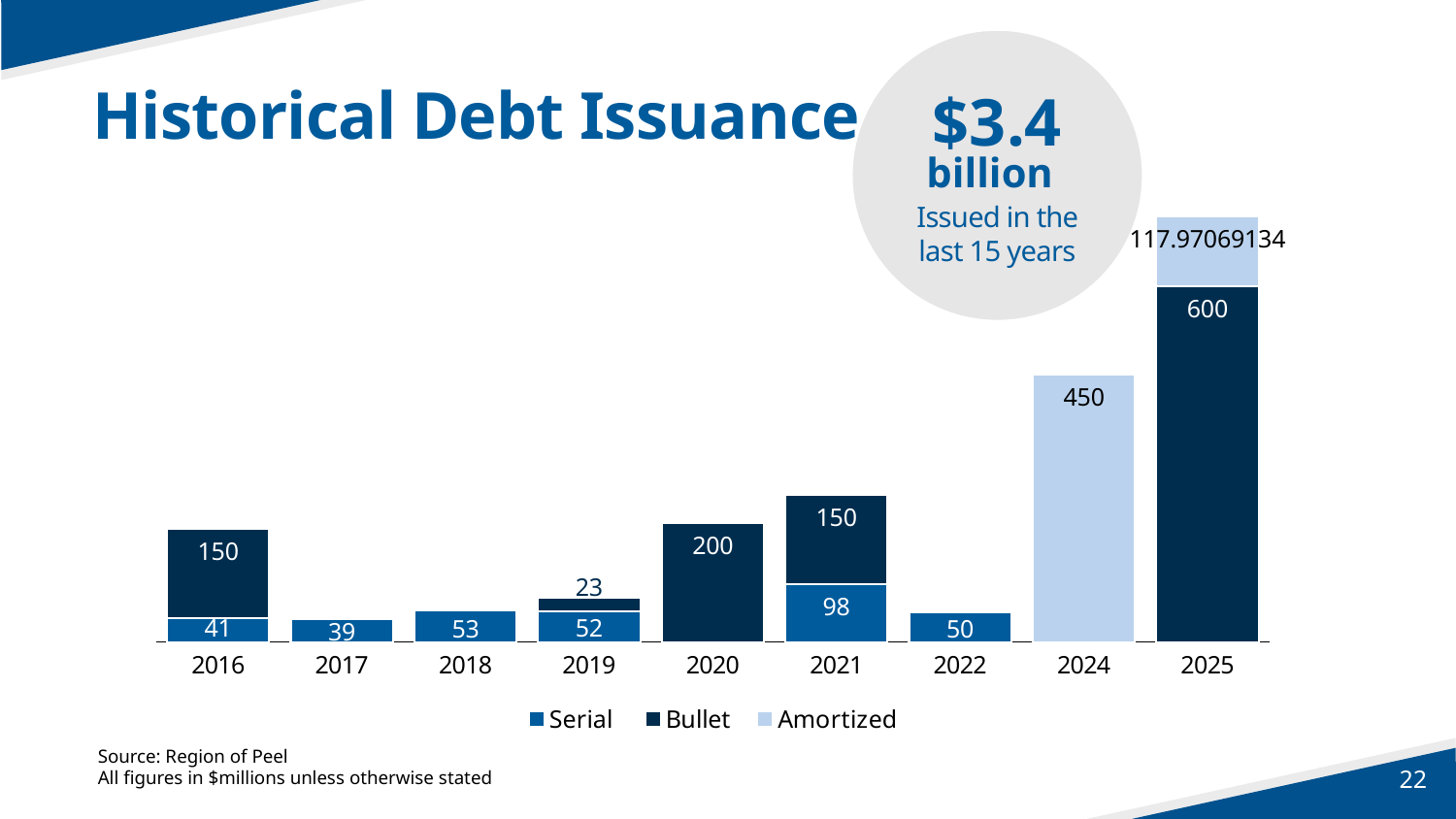
Which year has the highest Bullet value? 2025 Which is larger, the Bullet value for 2016 or the Bullet value for 2019? 2016 What is the Bullet value for 2020? 200 What is the Bullet value for 2025? 600 What is the Amortized value for 2024? 450 What is the total of the stacked bar for 2016? 191 What is the total of the stacked bar for 2021? 248 How many series does the legend list? 3 Which year has the lowest Serial value? 2017 What is the difference between the Serial values for 2018 and 2019? 1 What is the Serial value for 2021? 98 What is the Amortized value for 2025? 117.97069134